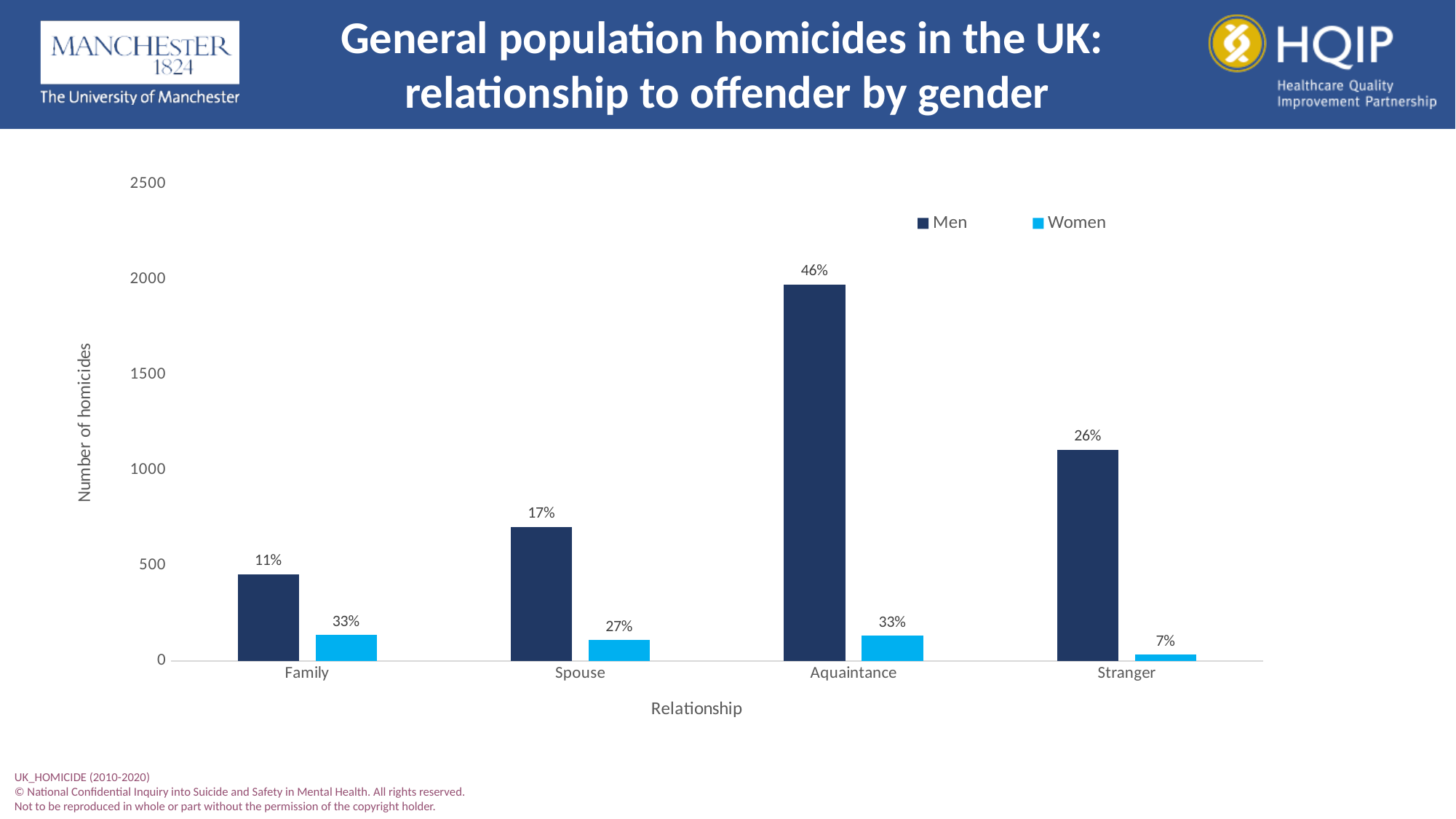
How many relationship categories are shown on the x axis? 4 What kind of chart is shown on the slide? bar chart What percentage label is shown on the Men bar for Aquaintance? 46% Is the number of homicides for Men in the Aquaintance category greater or less than 1500? greater How many series does the legend list? 2 Which relationship category has the shortest Women bar? Stranger What percentage label is shown on the Women bar for Stranger? 7% What percentage label is shown on the Women bar for Family? 33% Which Men bar is taller: Spouse or Stranger? Stranger Which relationship category has the tallest Men bar? Aquaintance Is the number of homicides for Men in the Family category greater or less than 500? less Is the number of homicides for Men in the Stranger category greater or less than 1000? greater